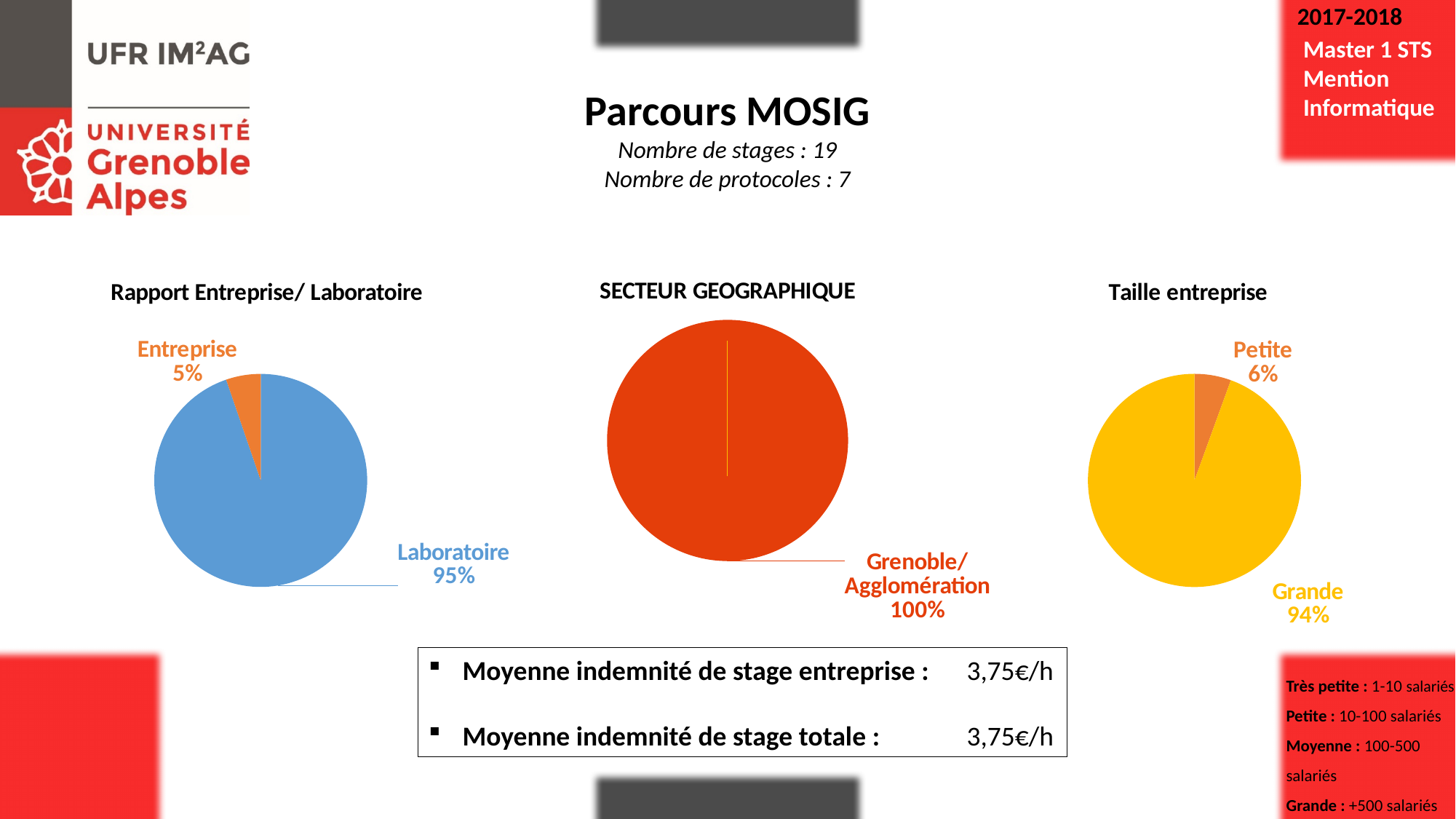
How many pie charts are shown on the slide? 3 In the 'Taille entreprise' chart, which category has the smallest share? Petite In the 'Taille entreprise' chart, what share does Petite have? 6% What type of chart is the 'Taille entreprise' chart? Pie chart In the 'SECTEUR GEOGRAPHIQUE' chart, what share does Grenoble/Agglomération have? 100% In the 'Rapport Entreprise/ Laboratoire' chart, what share does Entreprise have? 5% How many slices does the 'SECTEUR GEOGRAPHIQUE' chart have? 1 In the 'Rapport Entreprise/ Laboratoire' chart, what share does Laboratoire have? 95% In the 'Rapport Entreprise/ Laboratoire' chart, which category has the largest share? Laboratoire In the 'Taille entreprise' chart, is the share for Grande larger or smaller than the share for Petite? larger In the 'Rapport Entreprise/ Laboratoire' chart, what is the difference between the Laboratoire and Entreprise shares? 90% In the 'Taille entreprise' chart, what share does Grande have? 94%